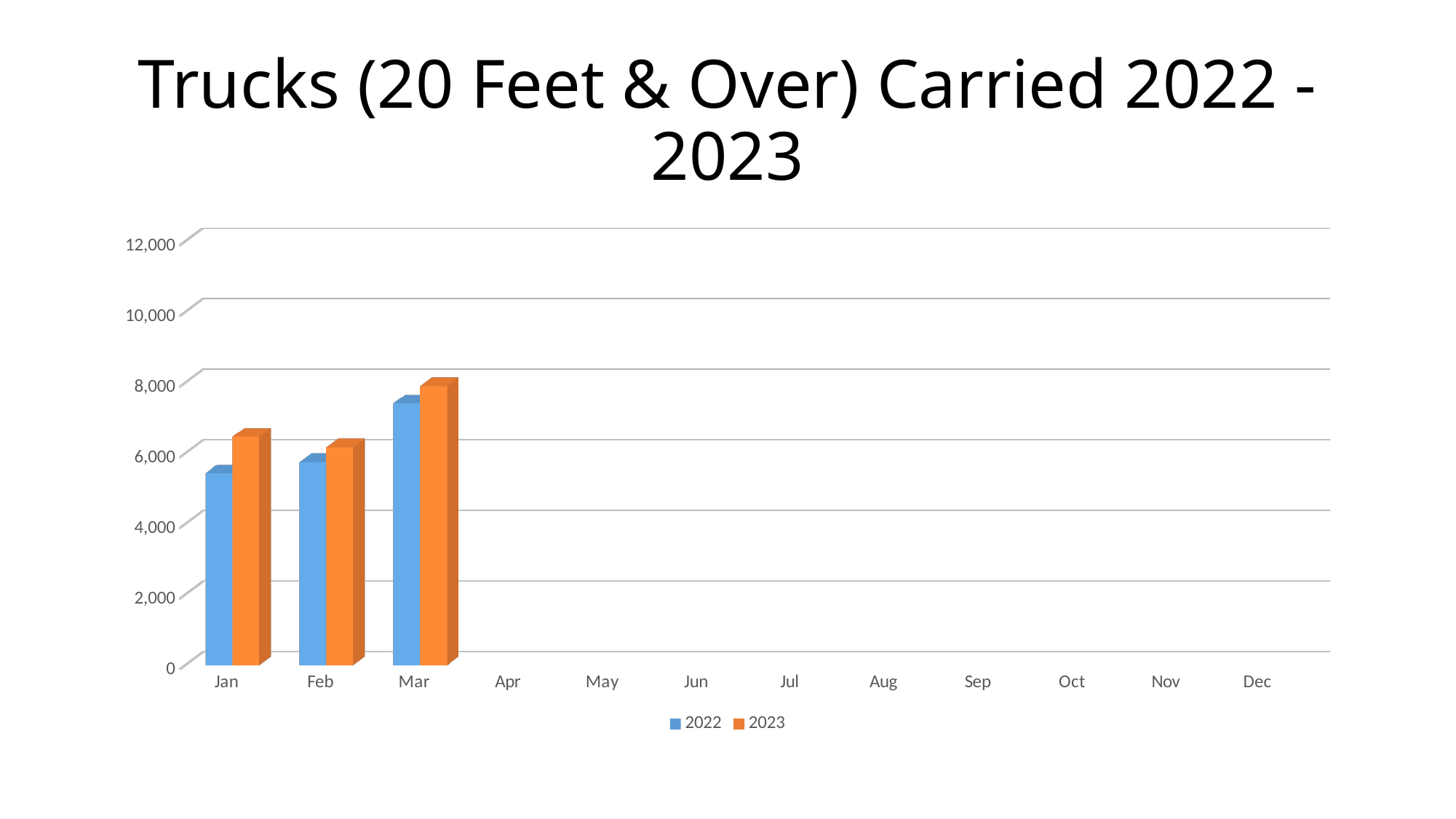
Which month has the highest value for 2022? Mar Which month has the highest value for 2023? Mar Is the value for Jan 2023 greater or less than 6,000? greater Which month has the lowest value for 2022? Jan Is the value for Jan 2022 greater or less than 6,000? less How many series does the legend list? 2 How many month categories are shown on the x axis? 12 In Jan, which series has the larger value, 2022 or 2023? 2023 Which series are listed in the legend? 2022 and 2023 What kind of chart is shown on the slide? bar chart Is the value for Mar 2022 greater or less than 6,000? greater How many months have bars plotted? 3